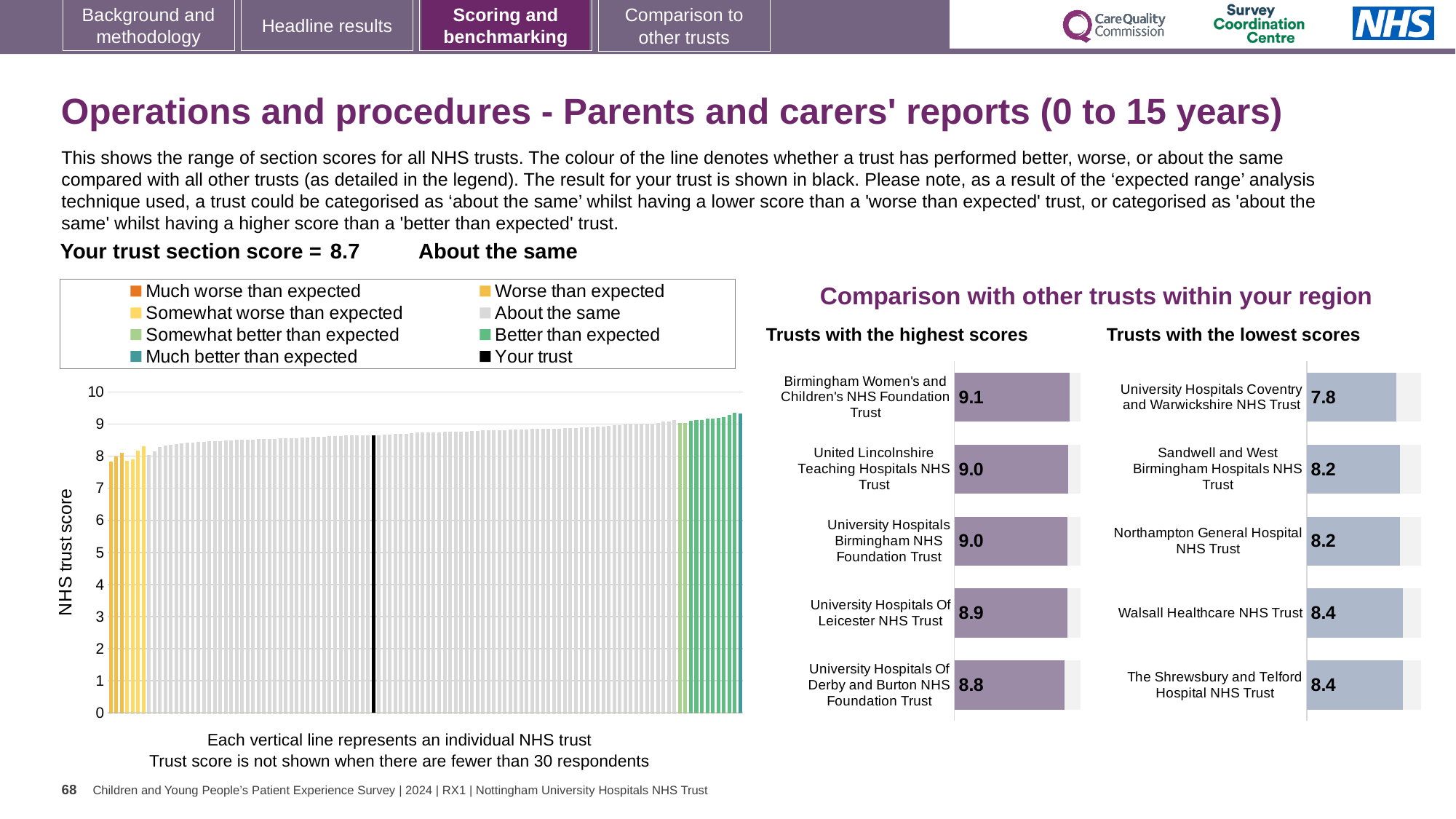
In the main chart of all NHS trusts on the left, is the value for the black 'Your trust' line greater or less than 8? greater In the 'Trusts with the lowest scores' chart, which trust has the lowest score? University Hospitals Coventry and Warwickshire NHS Trust How many entries does the legend of the main chart on the left list? 8 In the 'Trusts with the highest scores' chart, which trust has the highest score? Birmingham Women's and Children's NHS Foundation Trust In the 'Trusts with the highest scores' chart, what is the score for Birmingham Women's and Children's NHS Foundation Trust? 9.1 In the 'Trusts with the lowest scores' chart, what is the score for University Hospitals Coventry and Warwickshire NHS Trust? 7.8 In the 'Trusts with the lowest scores' chart, what is the difference between the scores of Walsall Healthcare NHS Trust and University Hospitals Coventry and Warwickshire NHS Trust? 0.6 In the 'Trusts with the highest scores' chart, what is the difference between the scores of Birmingham Women's and Children's NHS Foundation Trust and University Hospitals Of Derby and Burton NHS Foundation Trust? 0.3 In the 'Trusts with the lowest scores' chart, which has the larger score: Sandwell and West Birmingham Hospitals NHS Trust or Walsall Healthcare NHS Trust? Walsall Healthcare NHS Trust In the 'Trusts with the highest scores' chart, what is the score for University Hospitals Of Leicester NHS Trust? 8.9 In the main chart of all NHS trusts on the left, do the trust scores rise or fall from left to right? rise How many trusts are listed in the 'Trusts with the highest scores' chart? 5